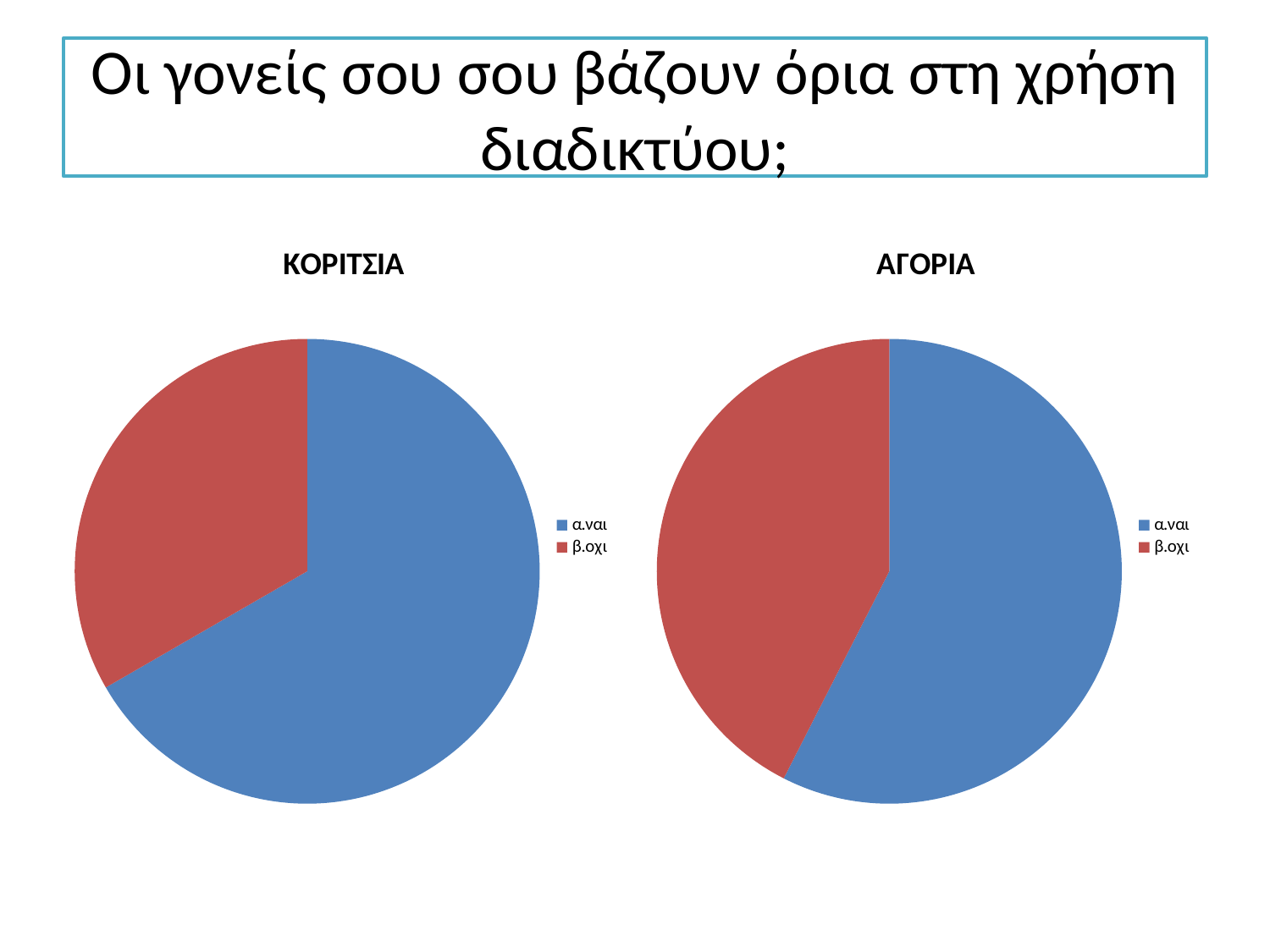
What is the title of the chart on the right of the slide? ΑΓΟΡΙΑ How many slices does the ΚΟΡΙΤΣΙΑ pie chart have? 2 In the ΚΟΡΙΤΣΙΑ chart, which is larger, the α.ναι slice or the β.οχι slice? α.ναι What kind of chart is the ΚΟΡΙΤΣΙΑ chart? pie chart In the ΑΓΟΡΙΑ chart, which slice is the largest? α.ναι In the ΑΓΟΡΙΑ chart, which slice is the smallest? β.οχι In the ΚΟΡΙΤΣΙΑ chart, which slice is the largest? α.ναι What colour is the β.οχι slice in the ΚΟΡΙΤΣΙΑ chart? red In the ΚΟΡΙΤΣΙΑ chart, which slice is the smallest? β.οχι What kind of chart is the ΑΓΟΡΙΑ chart? pie chart In the ΑΓΟΡΙΑ chart, which is larger, the α.ναι slice or the β.οχι slice? α.ναι How many entries does the legend of the ΑΓΟΡΙΑ chart list? 2